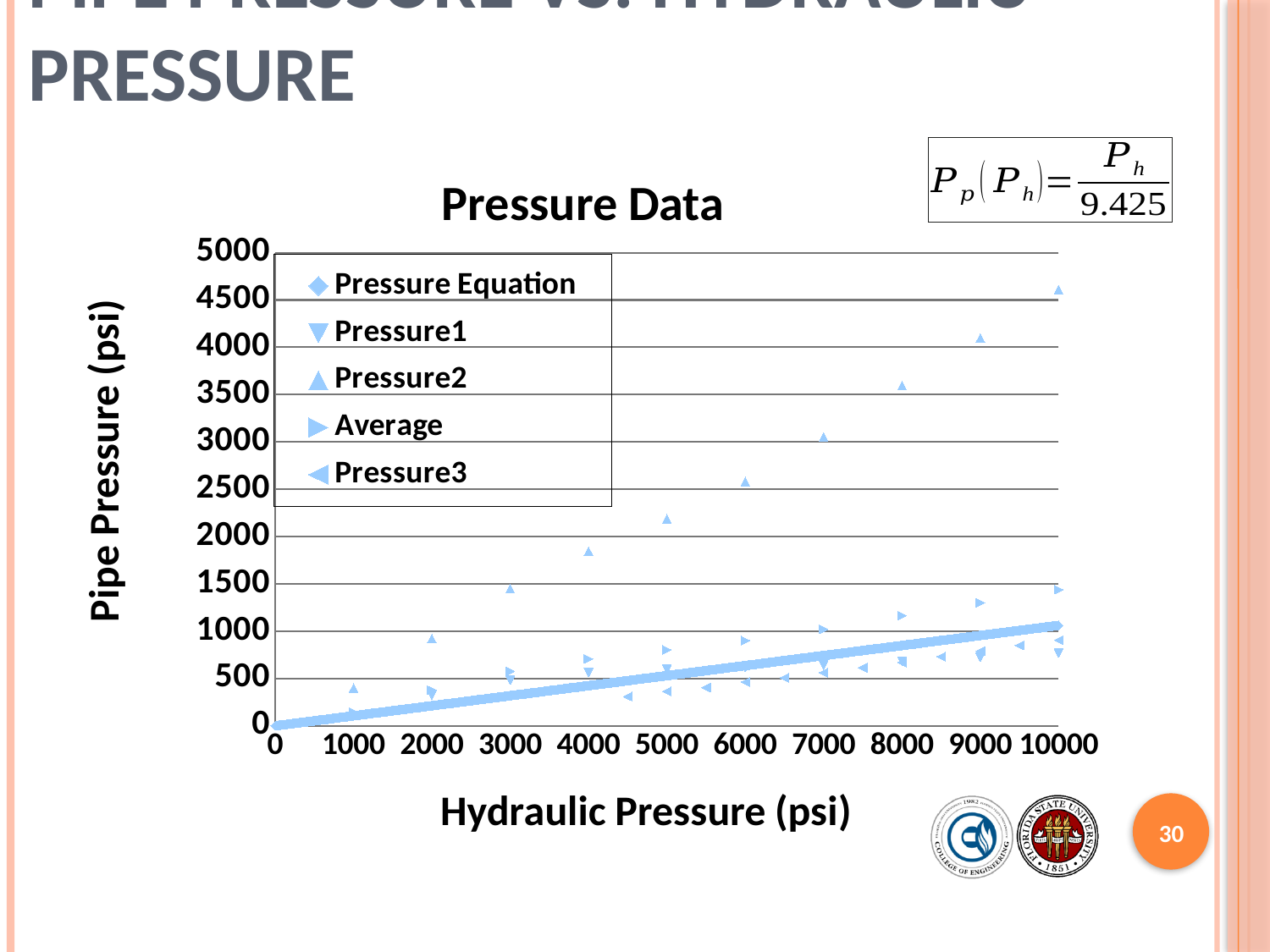
At a hydraulic pressure of 10000, which is larger: Pressure2 or Pressure3? Pressure2 Is the Pressure2 value at a hydraulic pressure of 10000 greater or less than 4000? greater Which series reaches the highest pipe pressure on the chart? Pressure2 What is the title of the chart? Pressure Data Is the Pressure3 value at a hydraulic pressure of 10000 greater or less than 1000? less How many series does the chart legend list? 5 Do the Pressure2 values rise or fall as hydraulic pressure increases? rise Is the Pressure2 value at a hydraulic pressure of 5000 greater or less than 2000? greater What is the label of the vertical axis? Pipe Pressure (psi) What kind of chart is shown on the slide? scatter chart